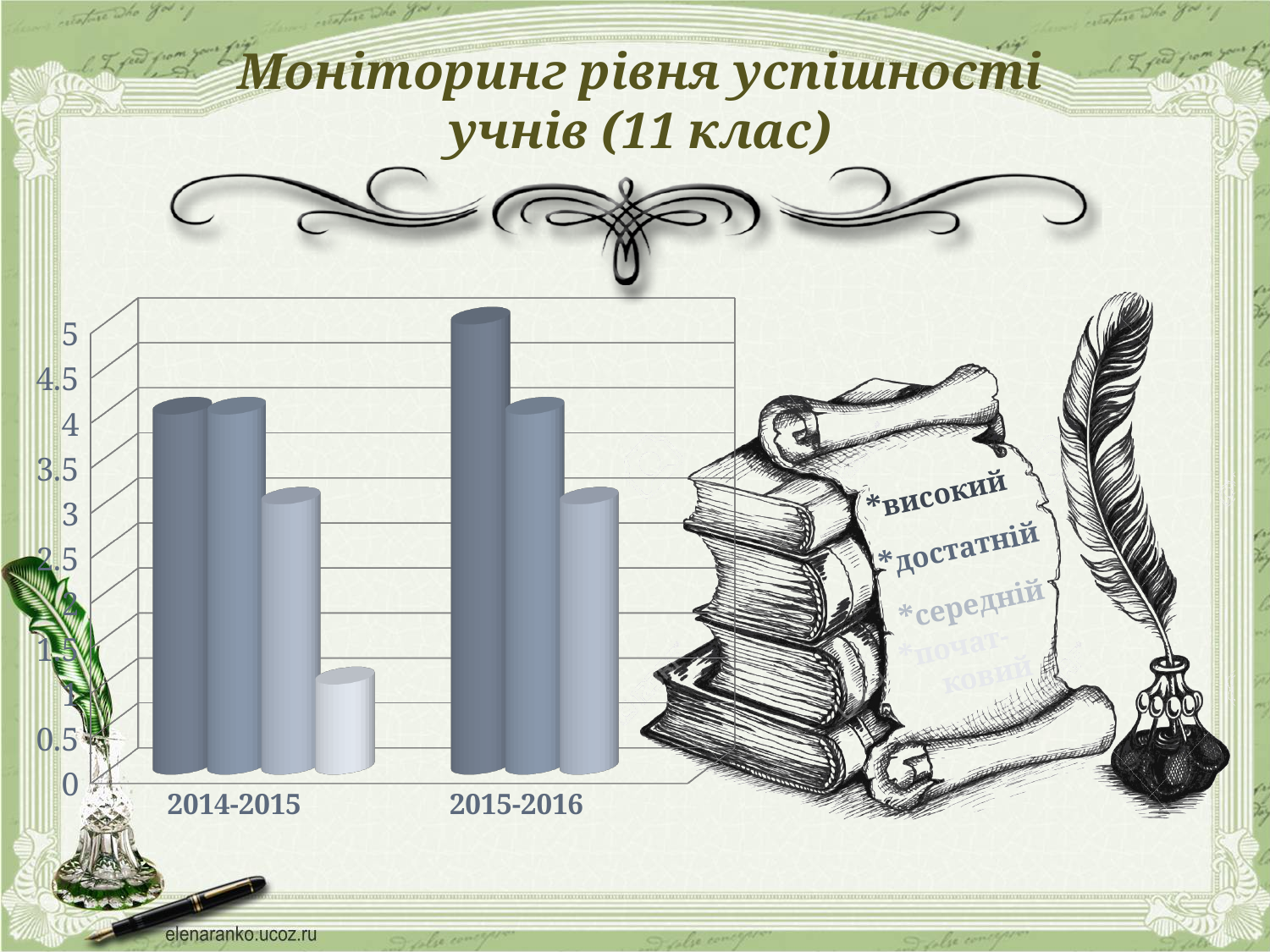
How many bars are plotted for the 2015-2016 category? 3 Is the value of the високий bar for 2015-2016 greater or less than 4.5? greater Does the високий bar rise or fall from 2014-2015 to 2015-2016? rises What is the title of the slide with the chart? Моніторинг рівня успішності учнів (11 клас) How many bars are plotted for the 2014-2015 category? 4 What is the value of the tallest bar (високий) for 2015-2016? 5 What is the value of the shortest bar (початковий) for 2014-2015? 1 Is the value of the середній bar for 2014-2015 greater or less than 3.5? less What kind of chart is shown on the slide? bar chart Which category has the taller високий bar, 2014-2015 or 2015-2016? 2015-2016 How many levels does the legend on the scroll list? 4 How many school-year categories are shown on the x axis of the chart? 2